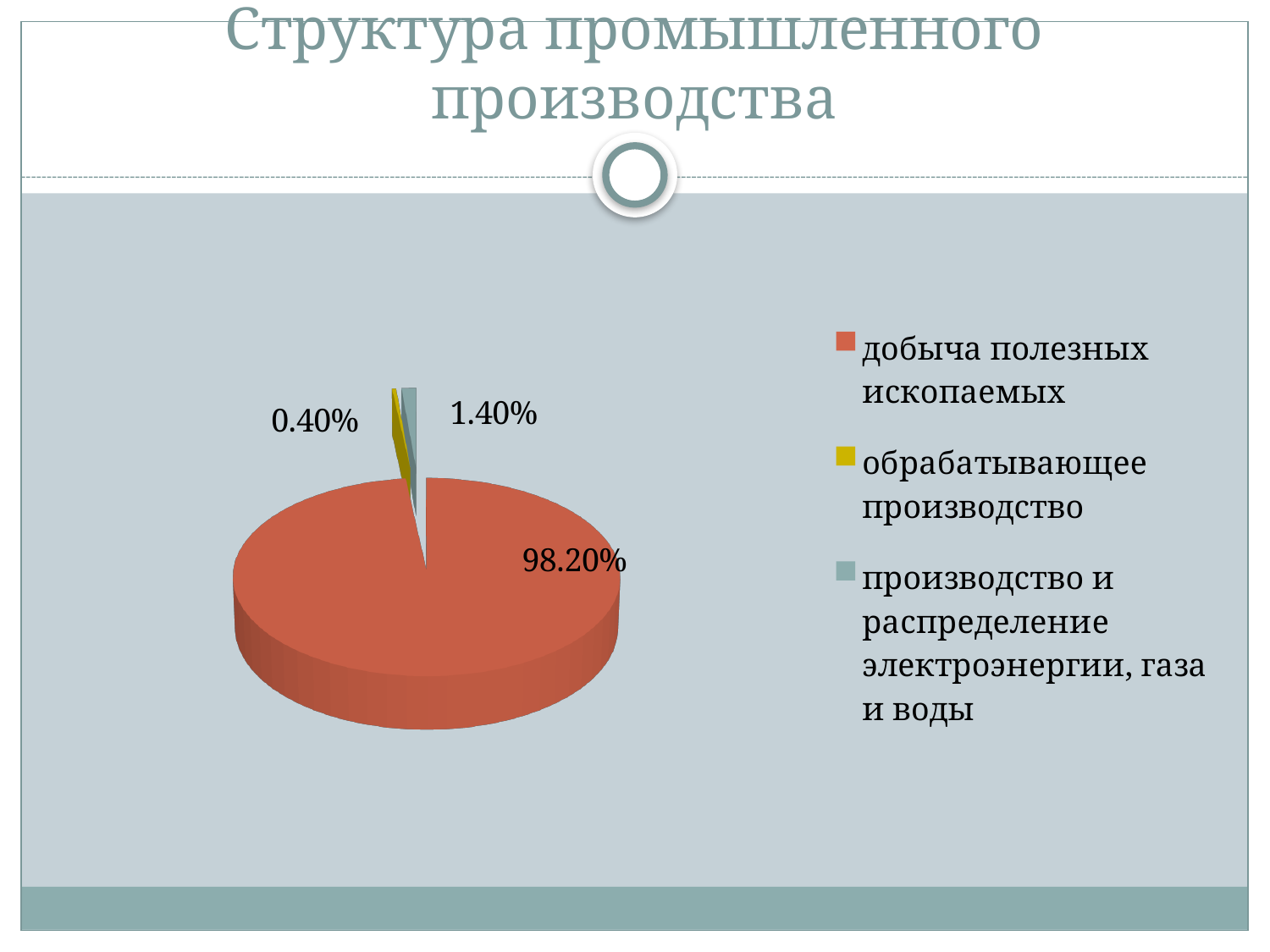
How many slices does the pie chart have? 3 What is the title of the chart slide? Структура промышленного производства Which category has the smallest slice of the pie? обрабатывающее производство How many entries does the legend list? 3 Which category has the largest slice of the pie? добыча полезных ископаемых What share of the pie does "производство и распределение электроэнергии, газа и воды" have? 1.40% What share of the pie does "обрабатывающее производство" have? 0.40% Which is larger: the share of "обрабатывающее производство" or the share of "производство и распределение электроэнергии, газа и воды"? производство и распределение электроэнергии, газа и воды What is the difference between the shares of "производство и распределение электроэнергии, газа и воды" and "обрабатывающее производство"? 1.00% What share of the pie does "добыча полезных ископаемых" have? 98.20% What colour is the slice for "добыча полезных ископаемых"? red What kind of chart is shown on the slide? pie chart